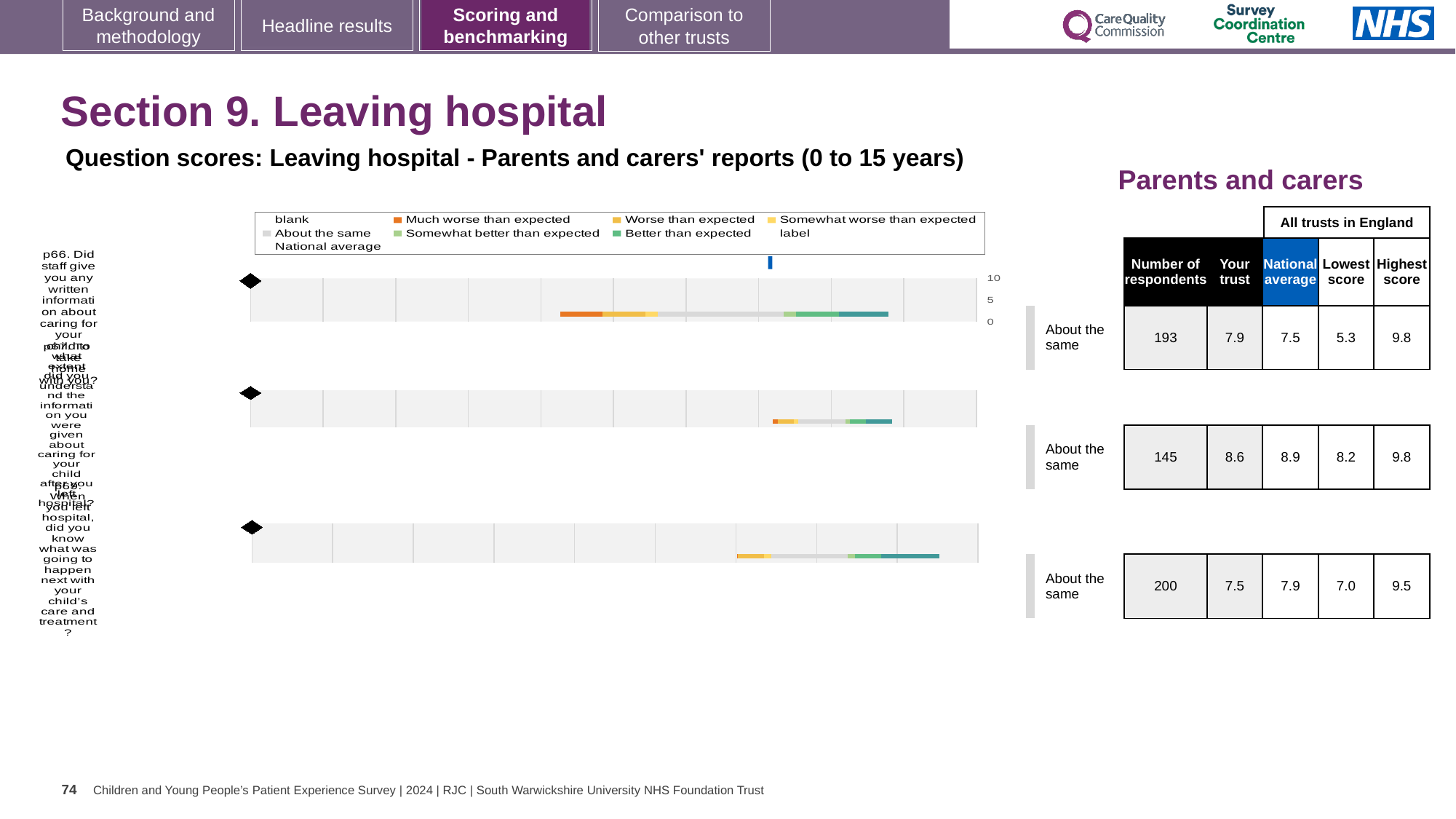
How many entries does the chart legend list? 9 In the table beside the charts, what is the number of respondents for the third question (p68)? 200 In the table beside the charts, what is the difference between the highest score and the lowest score for the first question (p66)? 4.5 How many separate question charts are shown on the slide? 3 In the table beside the charts, which question has the highest 'Your trust' score? p67 What kind of chart is used to show the question scores on this slide? bar chart In the table beside the charts, what is the 'Your trust' score for the first question (p66)? 7.9 In the table beside the charts, is the 'Your trust' score for the third question (p68) larger or smaller than its national average? smaller Which legend entry is shown in orange? Much worse than expected In the table beside the charts, what is the national average for the second question (p67)? 8.9 In the table beside the charts, what benchmark category is given for each of the three questions? About the same What is the highest tick value shown on the chart's axis? 10